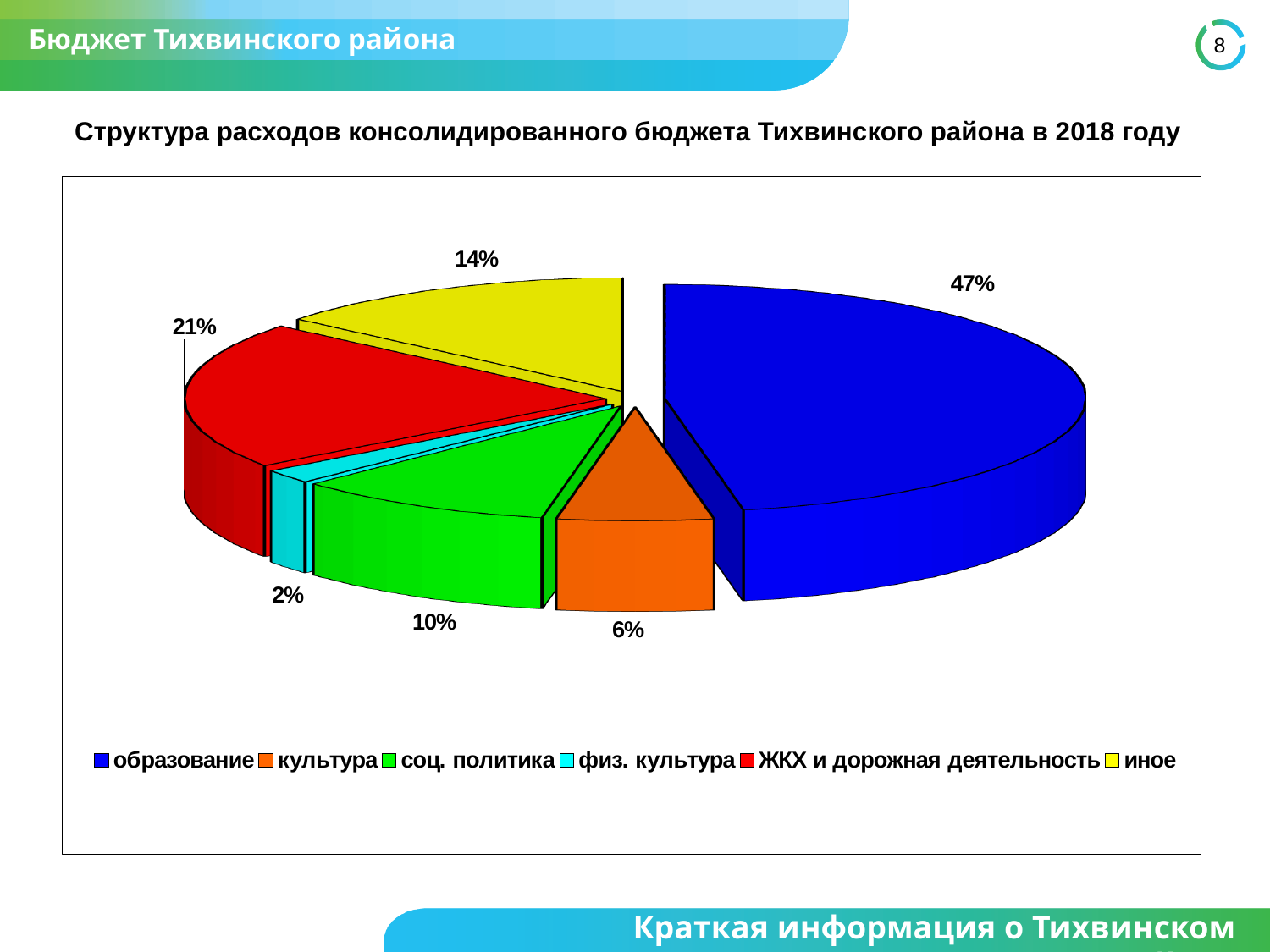
What share of expenditures goes to соц. политика? 10% What share of expenditures goes to иное? 14% What share of expenditures goes to образование? 47% Which category has the smallest share of the pie? физ. культура What type of chart is shown on the slide? pie chart What share of expenditures goes to ЖКХ и дорожная деятельность? 21% What share of expenditures goes to физ. культура? 2% What is the difference in percentage points between образование and ЖКХ и дорожная деятельность? 26 What colour is the slice for иное? yellow Which is larger, the share for культура or the share for соц. политика? соц. политика Which category has the largest share of the pie? образование How many categories does the legend list? 6